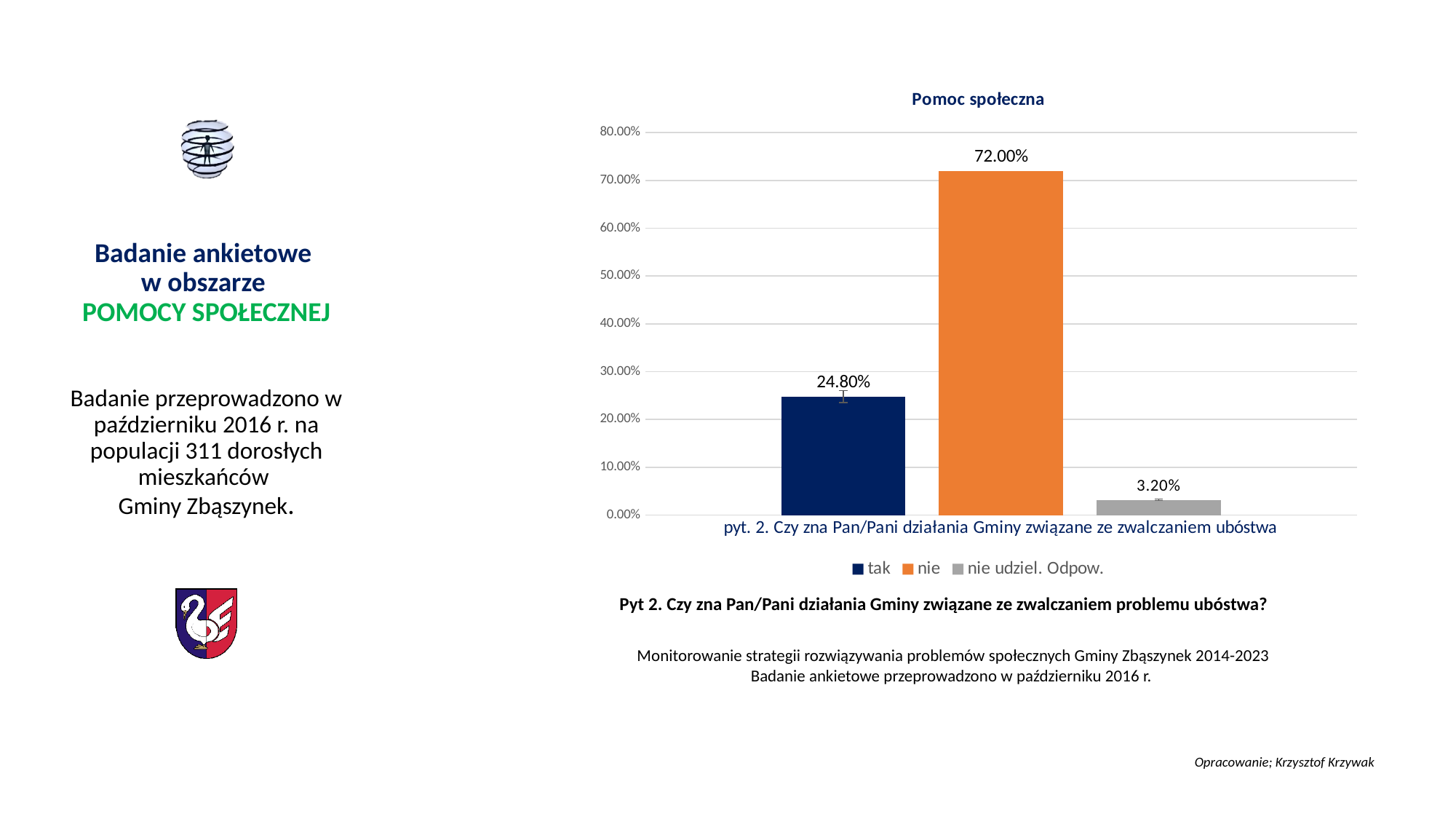
What is the difference between the values for "nie" and "tak"? 47.20% How many series does the legend list? 3 Which is larger, the value for "tak" or the value for "nie udziel. Odpow."? tak What is the value for "nie" in the chart? 72.00% What is the value for "tak" in the chart? 24.80% Is the value for "nie" greater or less than 70.00%? greater What is the value for "nie udziel. Odpow." in the chart? 3.20% Which series has the lowest value in the chart? nie udziel. Odpow. Which series has the highest value in the chart? nie What kind of chart is shown on the slide? bar chart What colour is the bar for "nie"? orange What is the title of the chart? Pomoc społeczna